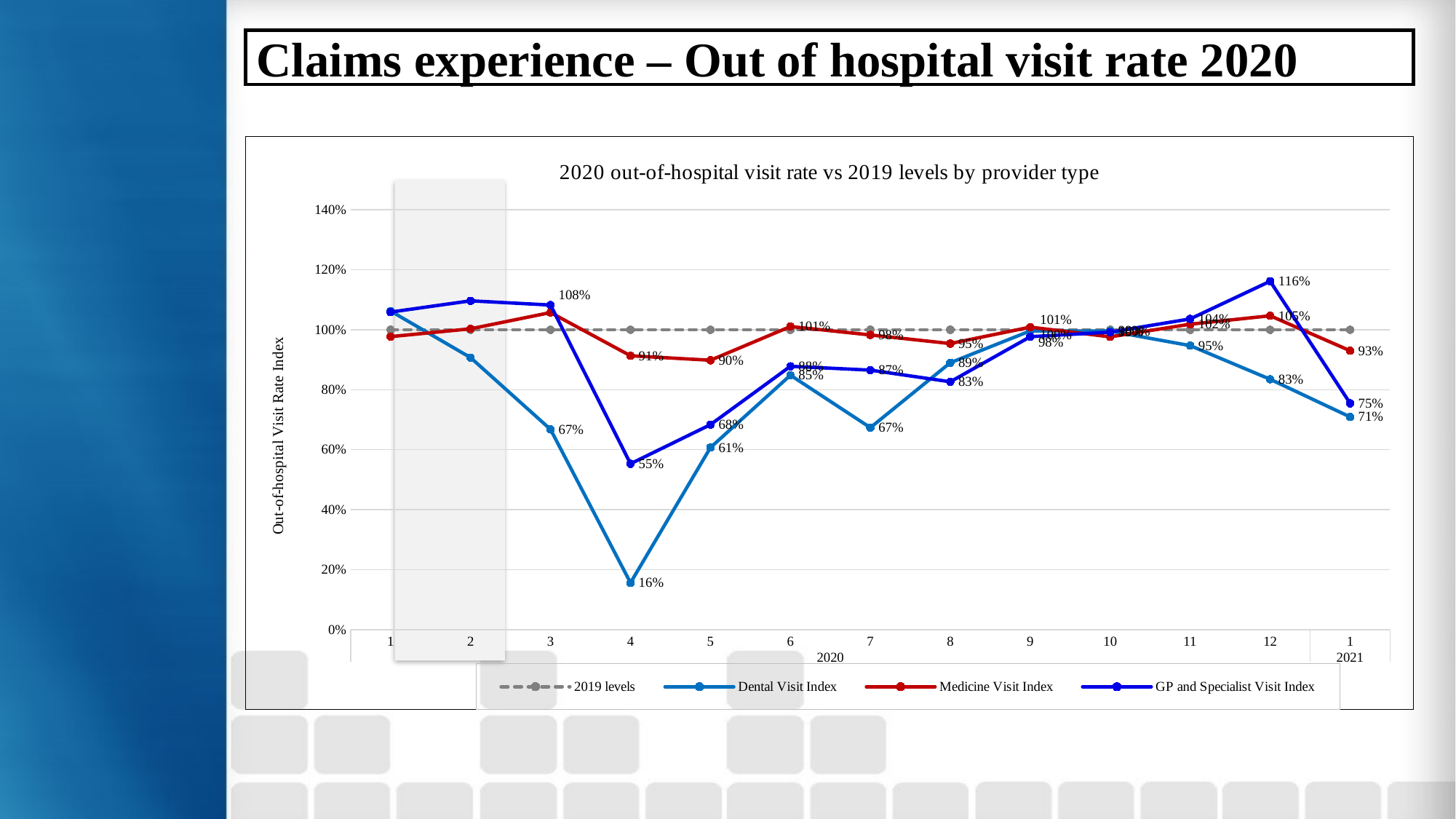
Does the Dental Visit Index rise or fall from month 10 of 2020 to month 1 of 2021? fall What is the Medicine Visit Index value in month 1 of 2021? 93% In month 4 of 2020, which is higher: the Medicine Visit Index or the GP and Specialist Visit Index? Medicine Visit Index What is the GP and Specialist Visit Index value in month 12 of 2020? 116% In which month does the GP and Specialist Visit Index reach its highest value? 12 What kind of chart is shown on the slide? line chart How many points are plotted along the x axis for each series? 13 In which month does the Dental Visit Index reach its lowest value? 4 How many series does the legend list? 4 Is the Dental Visit Index value in month 2 of 2020 greater or less than 100%? less By how many percentage points does the Dental Visit Index rise from month 4 to month 5 of 2020? 45 percentage points What is the Dental Visit Index value in month 4 of 2020? 16%